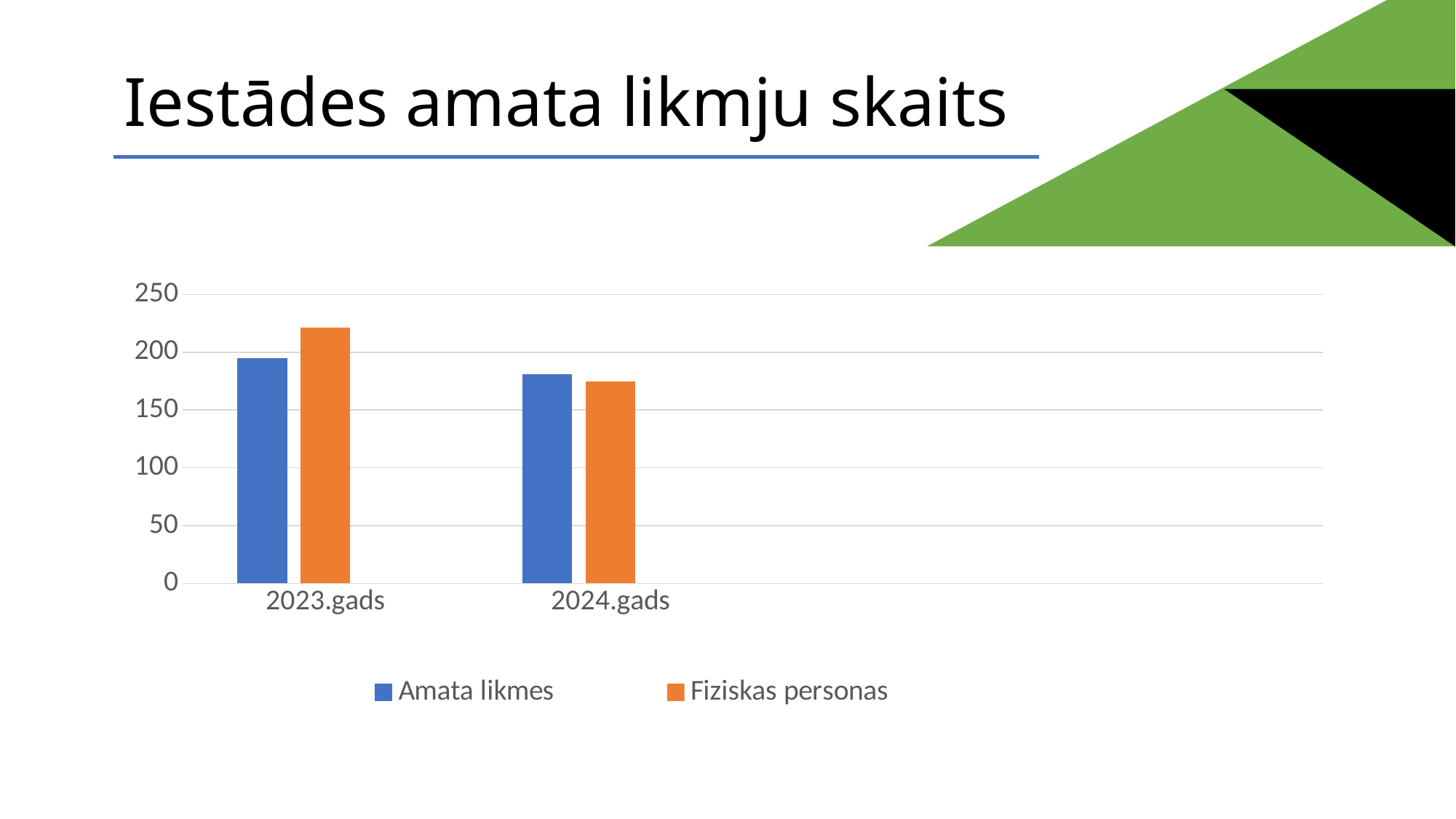
For Fiziskas personas, which year has the larger value: 2023.gads or 2024.gads? 2023.gads How many series does the legend list? 2 In 2023.gads, which is larger: Amata likmes or Fiziskas personas? Fiziskas personas Is the value for Fiziskas personas in 2023.gads greater or less than 200? greater Does the value for Fiziskas personas rise or fall from 2023.gads to 2024.gads? fall Is the value for Fiziskas personas in 2024.gads greater or less than 200? less What kind of chart is shown on the slide? bar chart Which series is shown in orange? Fiziskas personas Is the value for Amata likmes in 2024.gads greater or less than 150? greater What is the title of the slide containing the chart? Iestādes amata likmju skaits How many categories are shown on the x axis? 2